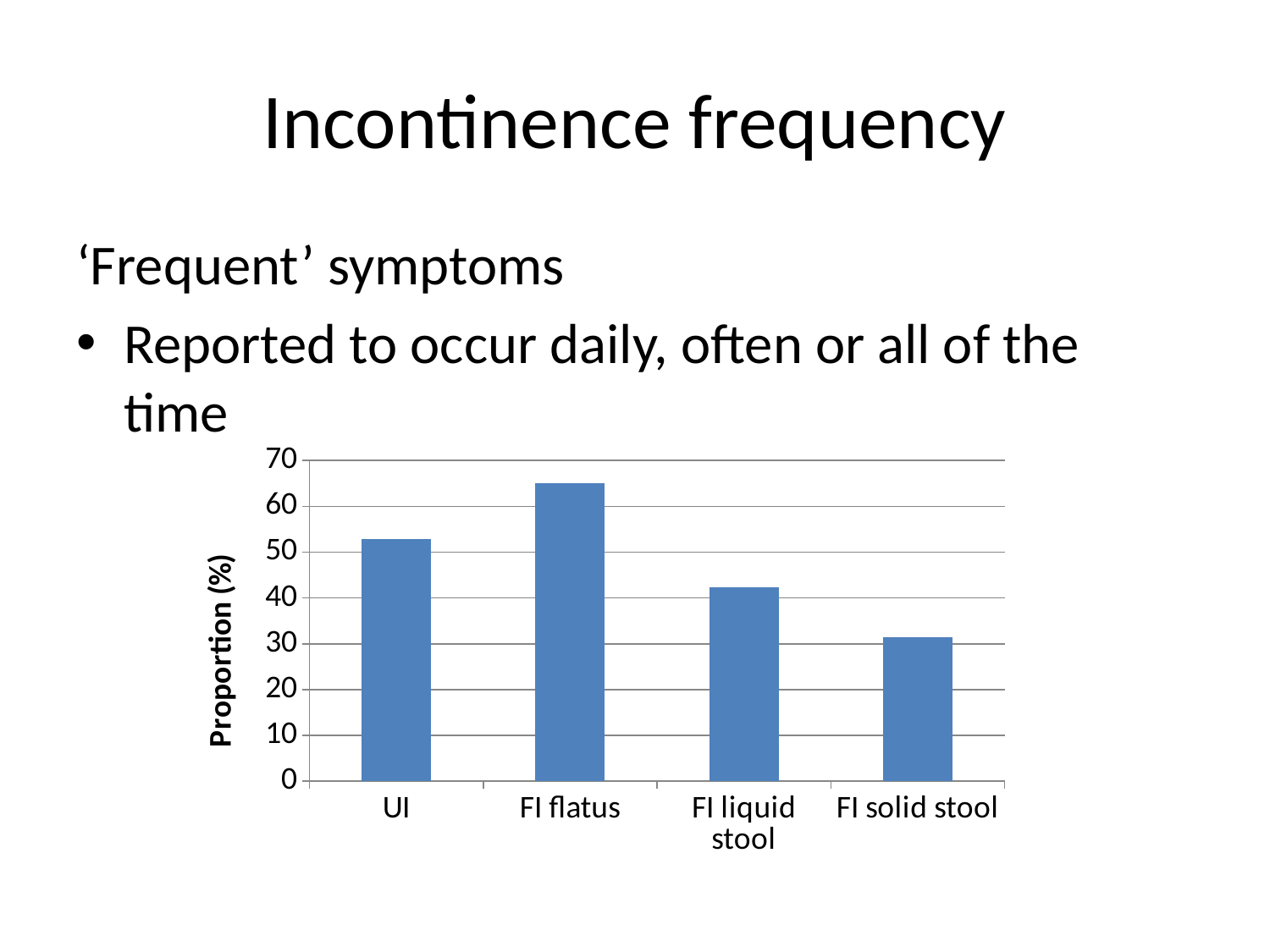
Is the value for UI greater or less than 40? greater Is the value for FI liquid stool greater or less than 50? less How many categories are shown on the x axis? 4 What is the label of the y axis? Proportion (%) Which category has the lowest proportion? FI solid stool Which category has the highest proportion? FI flatus Is the value for FI flatus greater or less than 60? greater Which is larger, the value for FI flatus or the value for FI solid stool? FI flatus Which is larger, the value for UI or the value for FI liquid stool? UI Do the values rise or fall from FI flatus to FI solid stool along the x axis? fall What type of chart is shown on the slide? bar chart